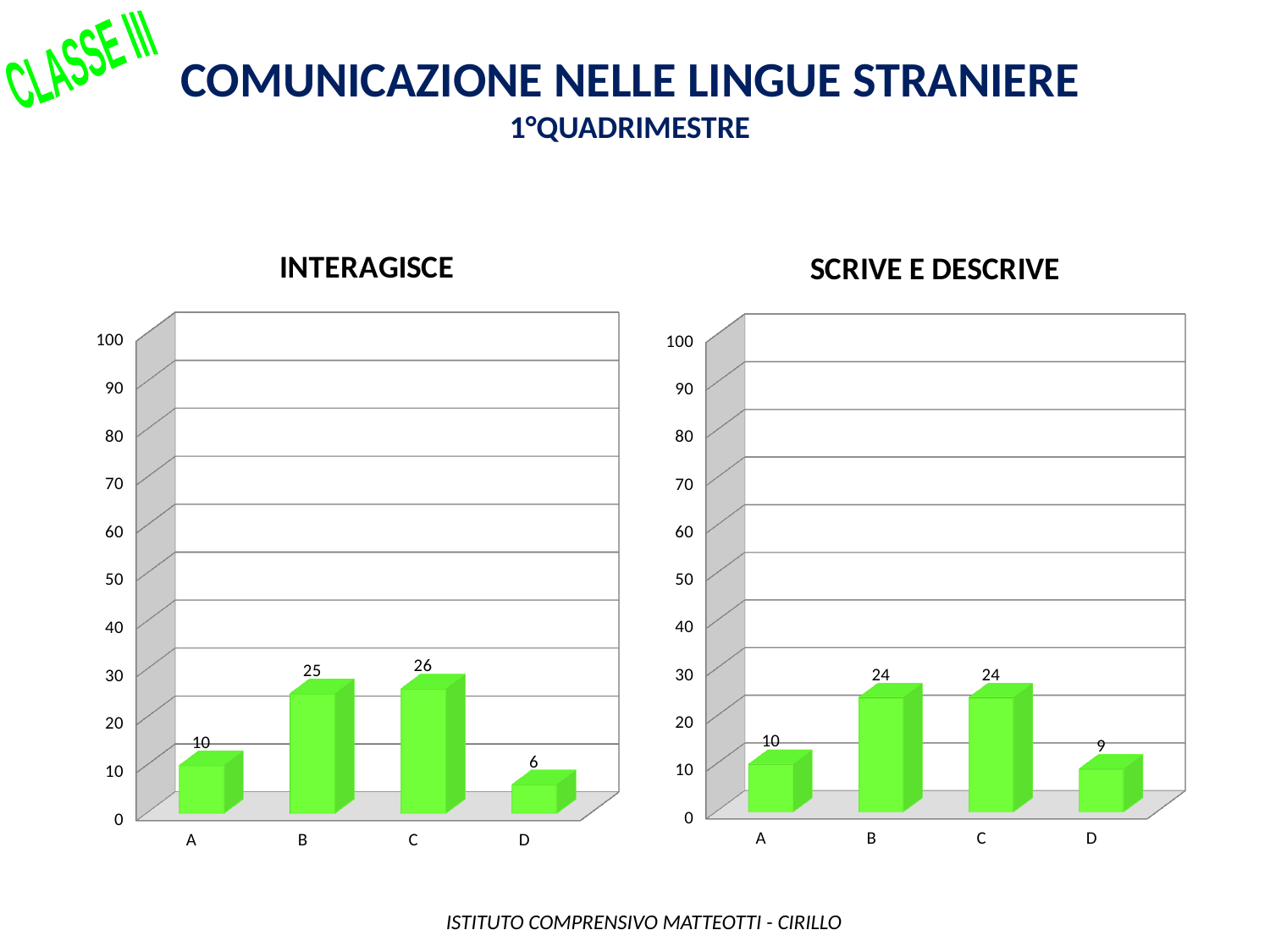
In the INTERAGISCE chart, what is the value for D? 6 In the INTERAGISCE chart, which is larger, the value for A or the value for B? B In the INTERAGISCE chart, which category has the lowest value? D In the INTERAGISCE chart, what is the difference between the values for C and A? 16 In the SCRIVE E DESCRIVE chart, what is the difference between the values for B and D? 15 In the SCRIVE E DESCRIVE chart, what is the value for A? 10 In the SCRIVE E DESCRIVE chart, which category has the lowest value? D In the SCRIVE E DESCRIVE chart, what is the value for D? 9 What kind of chart is the INTERAGISCE chart? Bar chart In the INTERAGISCE chart, what is the value for B? 25 In the INTERAGISCE chart, which category has the highest value? C How many categories are shown in the SCRIVE E DESCRIVE chart? 4